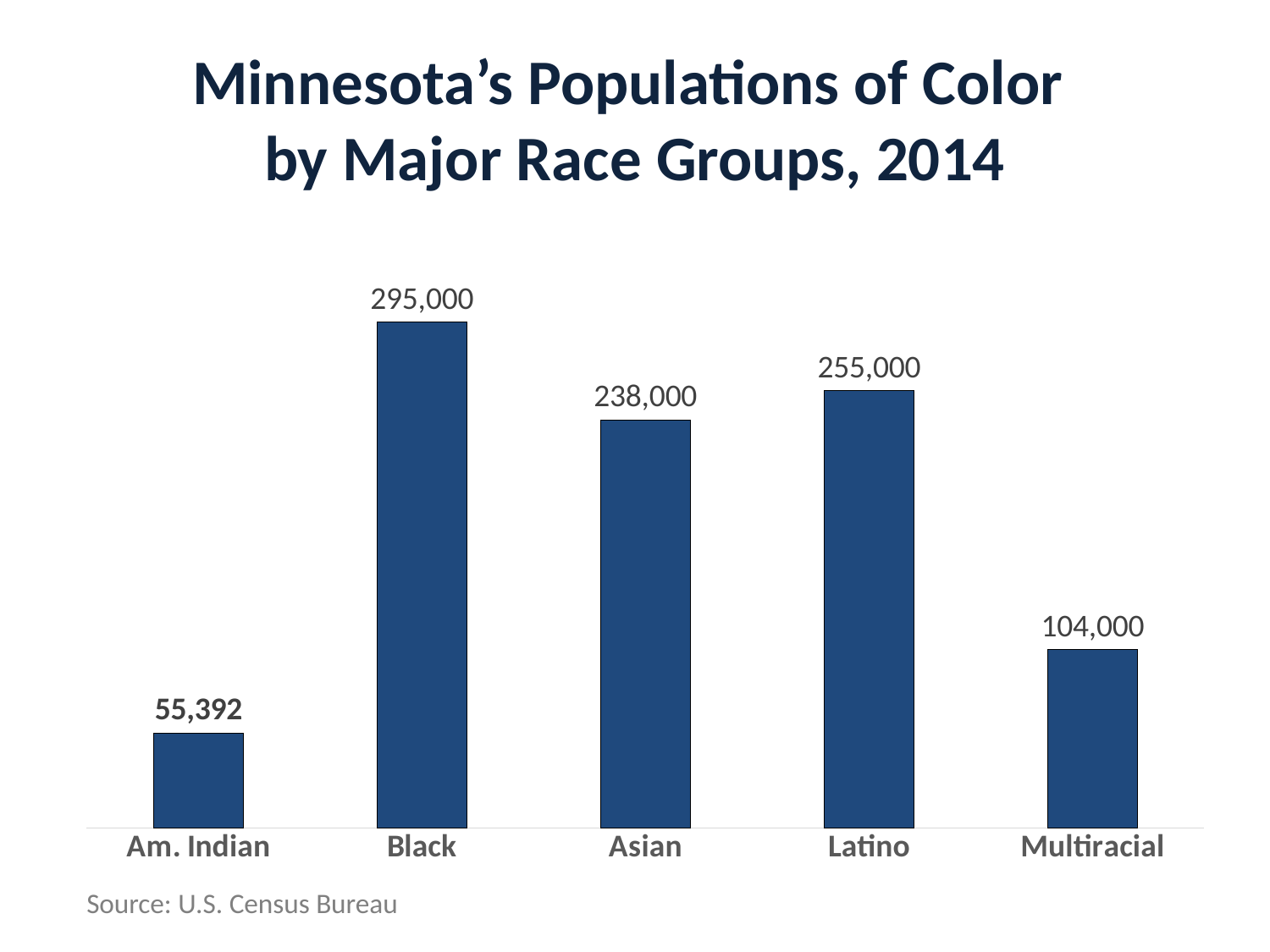
What is the population value shown for Latino? 255,000 What is the difference between the Black and Asian populations? 57,000 What is the population value shown for Am. Indian? 55,392 What is the difference between the Latino and Multiracial populations? 151,000 What is the source cited for the chart's data? U.S. Census Bureau Which race group has the lowest population on the chart? Am. Indian What is the population value shown for Multiracial? 104,000 What kind of chart is shown on the slide? Bar chart Which race group has the highest population on the chart? Black Which is larger, the Asian population or the Latino population? Latino What is the population value shown for Black? 295,000 How many race groups are shown on the chart? 5